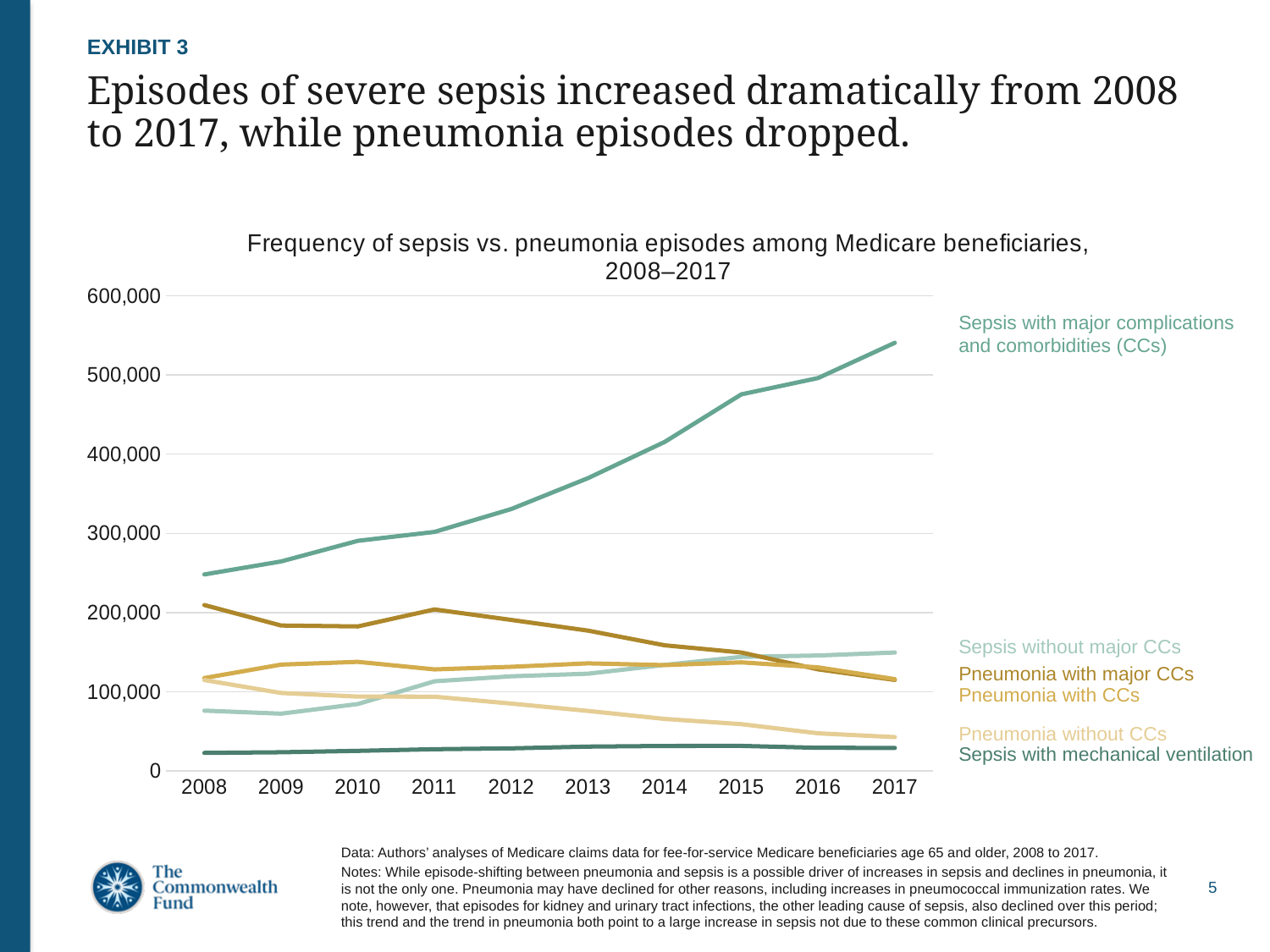
What is the title of the chart? Frequency of sepsis vs. pneumonia episodes among Medicare beneficiaries, 2008–2017 How many series does the chart show? 6 Is the value for sepsis with major CCs in 2017 greater or less than 500,000? greater Which series has the lowest value in 2008? Sepsis with mechanical ventilation Does the line for pneumonia with major CCs rise or fall from 2008 to 2017? fall Is the value for pneumonia without CCs in 2017 greater or less than 100,000? less Which series has the highest value in 2017? Sepsis with major complications and comorbidities (CCs) In 2008, which is larger: pneumonia with major CCs or sepsis without major CCs? Pneumonia with major CCs What kind of chart is shown on the slide? line chart How many years are plotted along the x axis? 10 Does the line for sepsis with major complications and comorbidities (CCs) rise or fall from 2008 to 2017? rise Is the value for sepsis with major CCs in 2008 greater or less than 300,000? less